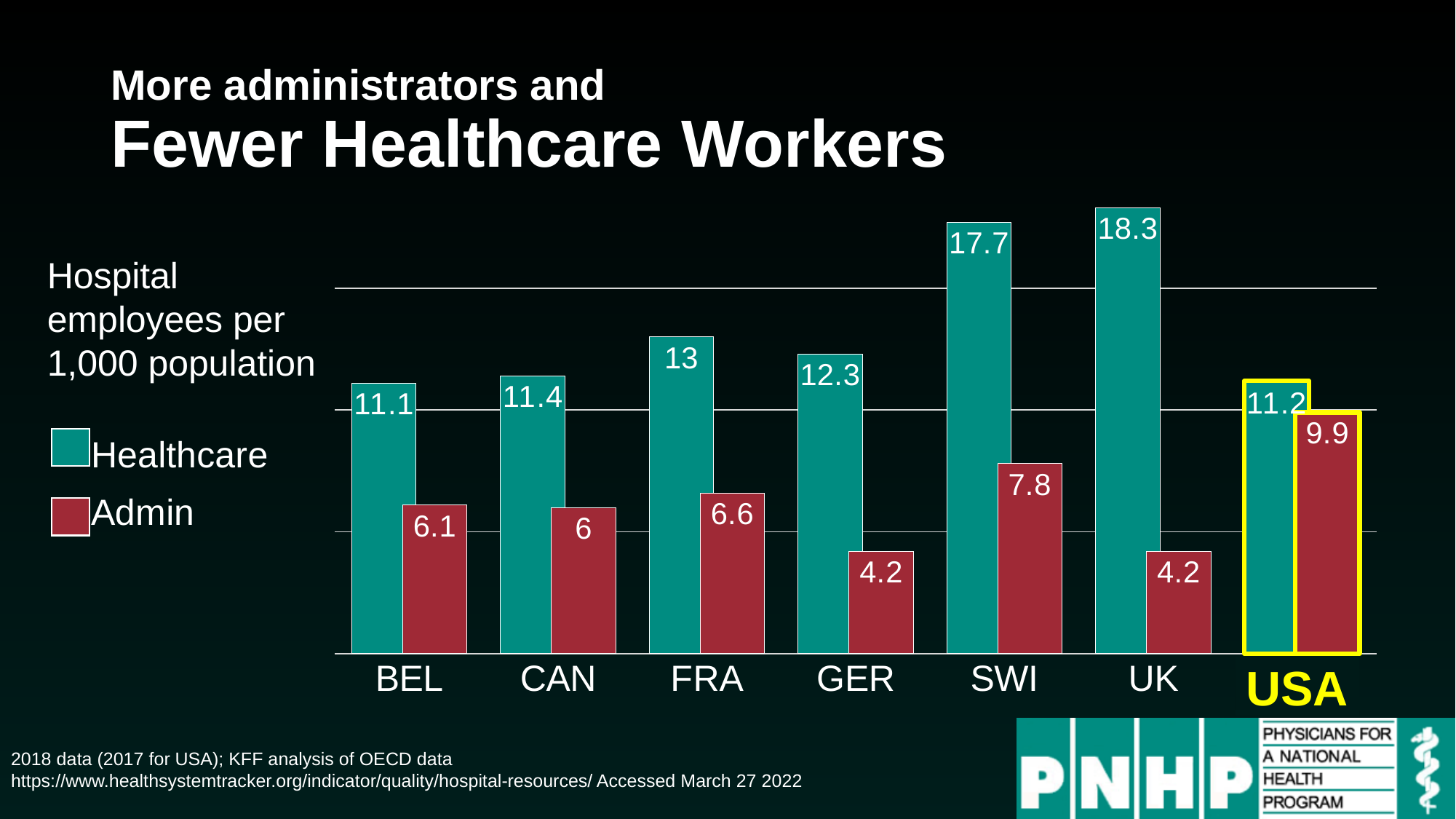
Which country has the lowest Healthcare value? BEL How many countries are shown on the x axis? 7 What is the Admin value for CAN? 6 Which is larger, the Admin value for SWI or the Admin value for FRA? SWI What is the difference between the Healthcare and Admin values for the USA? 1.3 What kind of chart is shown on the slide? Bar chart How many series does the legend list? 2 Which country has the highest Admin value? USA What is the Healthcare value for the UK? 18.3 Which country has the highest Healthcare value? UK What is the Admin value for the USA? 9.9 What is the Healthcare value for GER? 12.3